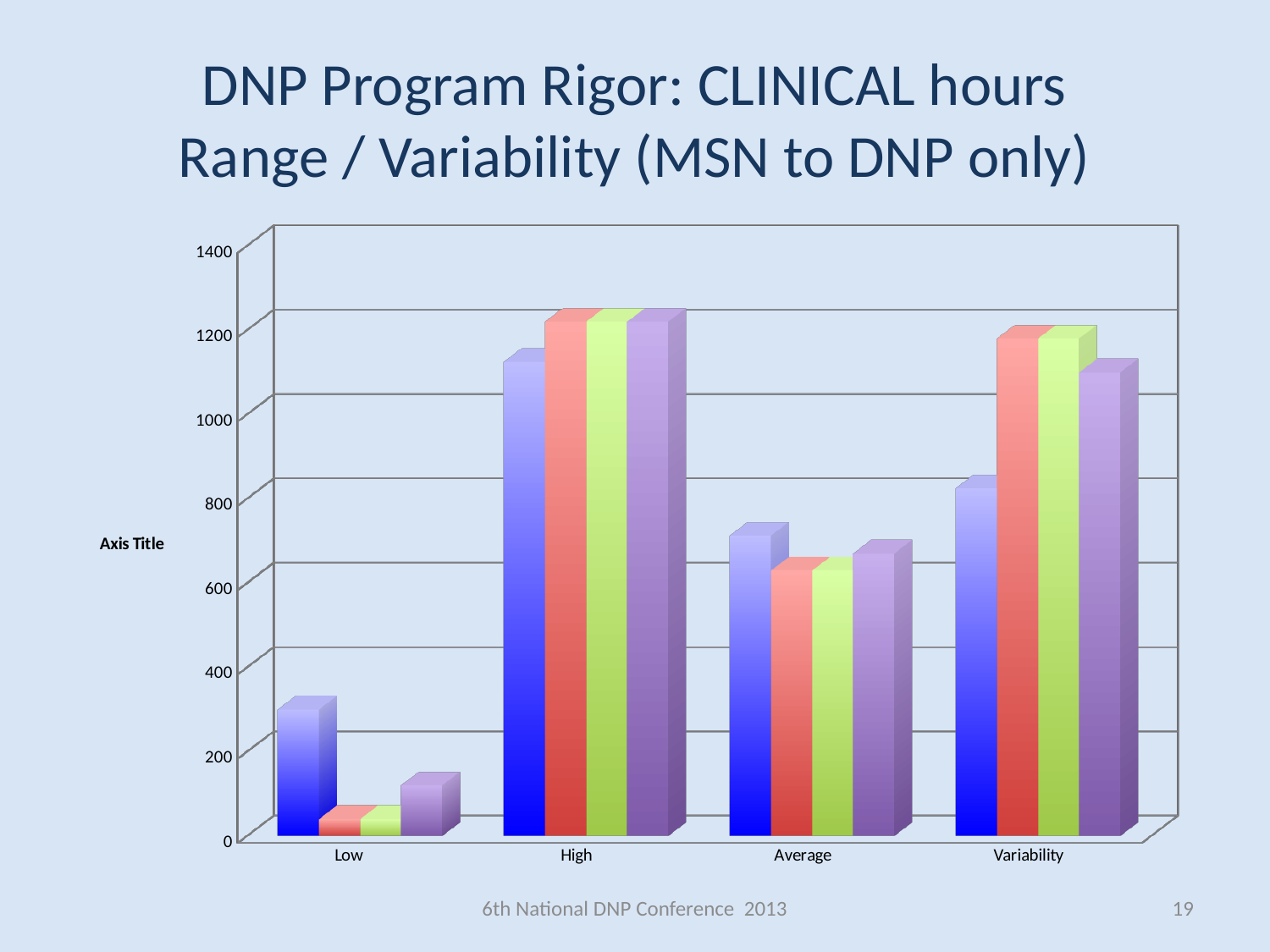
How many categories are shown on the x axis of the chart? 4 Is the purple bar for Variability greater or less than 1000? greater What is the label on the vertical axis of the chart? Axis Title Which category has the tallest blue bar? High In the Low category, which is larger, the blue bar or the red bar? the blue bar Is the red bar for Low greater or less than 200? less Is the red bar for Average greater or less than 800? less Which category has the shortest bars overall? Low In the Variability category, which is larger, the red bar or the purple bar? the red bar What kind of chart is shown on the slide? bar chart